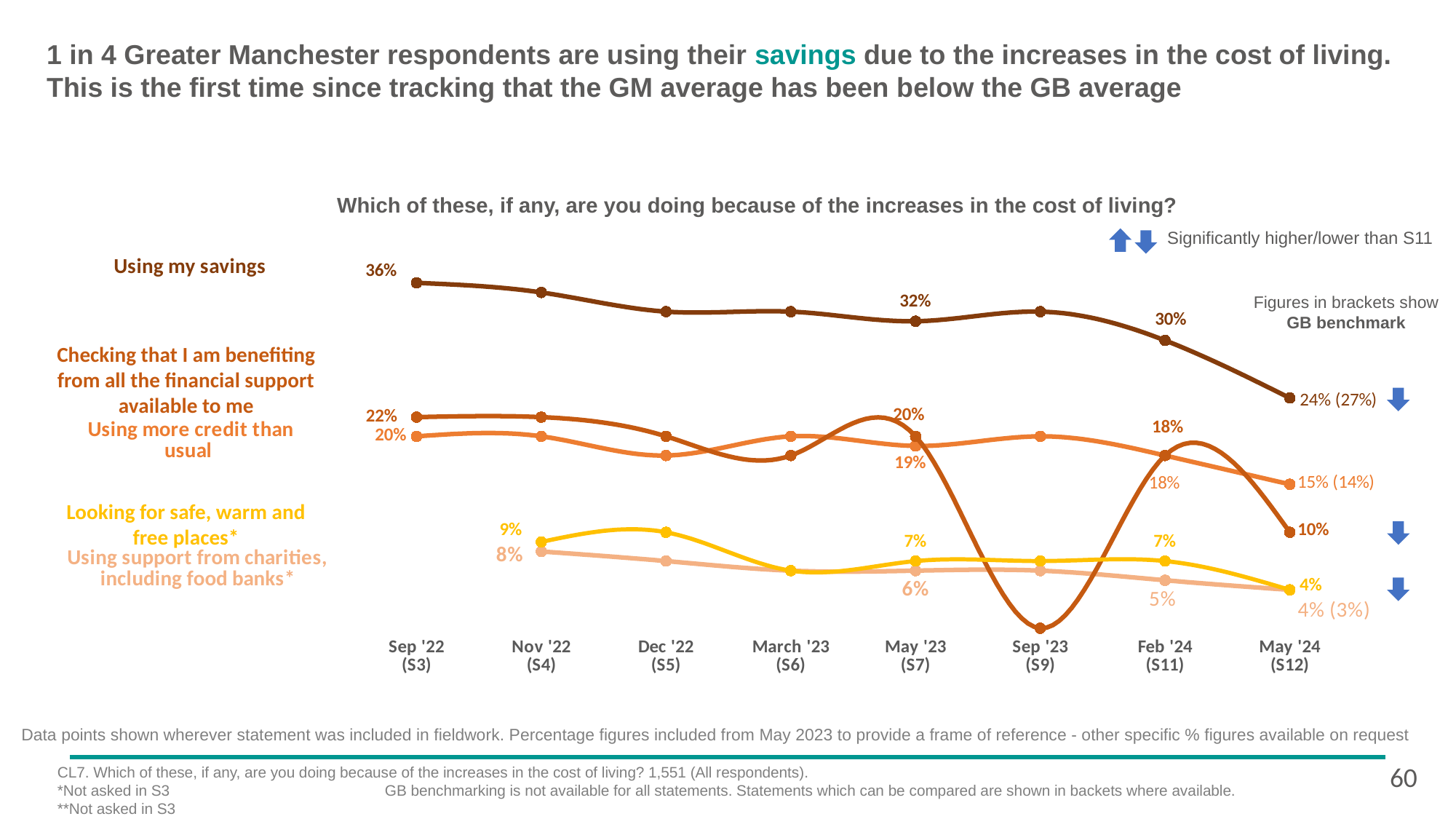
What is the value for 'Using more credit than usual' in May '24 (S12)? 15% By how many percentage points did 'Checking that I am benefiting from all the financial support available to me' change between Feb '24 (S11) at 18% and May '24 (S12) at 10%? 8 percentage points By how many percentage points did 'Using my savings' fall between Sep '22 (S3) and May '24 (S12)? 12 percentage points What is the value for 'Looking for safe, warm and free places' in Nov '22 (S4)? 9% What percentage of respondents were 'Using my savings' in Sep '22 (S3)? 36% How many survey waves are shown on the x axis? 8 What kind of chart is shown on the slide? Line chart Does the 'Using my savings' line rise or fall from Sep '22 to May '24? Fall What is the value for 'Checking that I am benefiting from all the financial support available to me' in May '24 (S12)? 10% What is the GB benchmark shown in brackets for 'Using my savings' in May '24 (S12)? 27% Which statement has the highest value in May '24 (S12)? Using my savings What is the Greater Manchester value for 'Using my savings' in May '24 (S12)? 24%